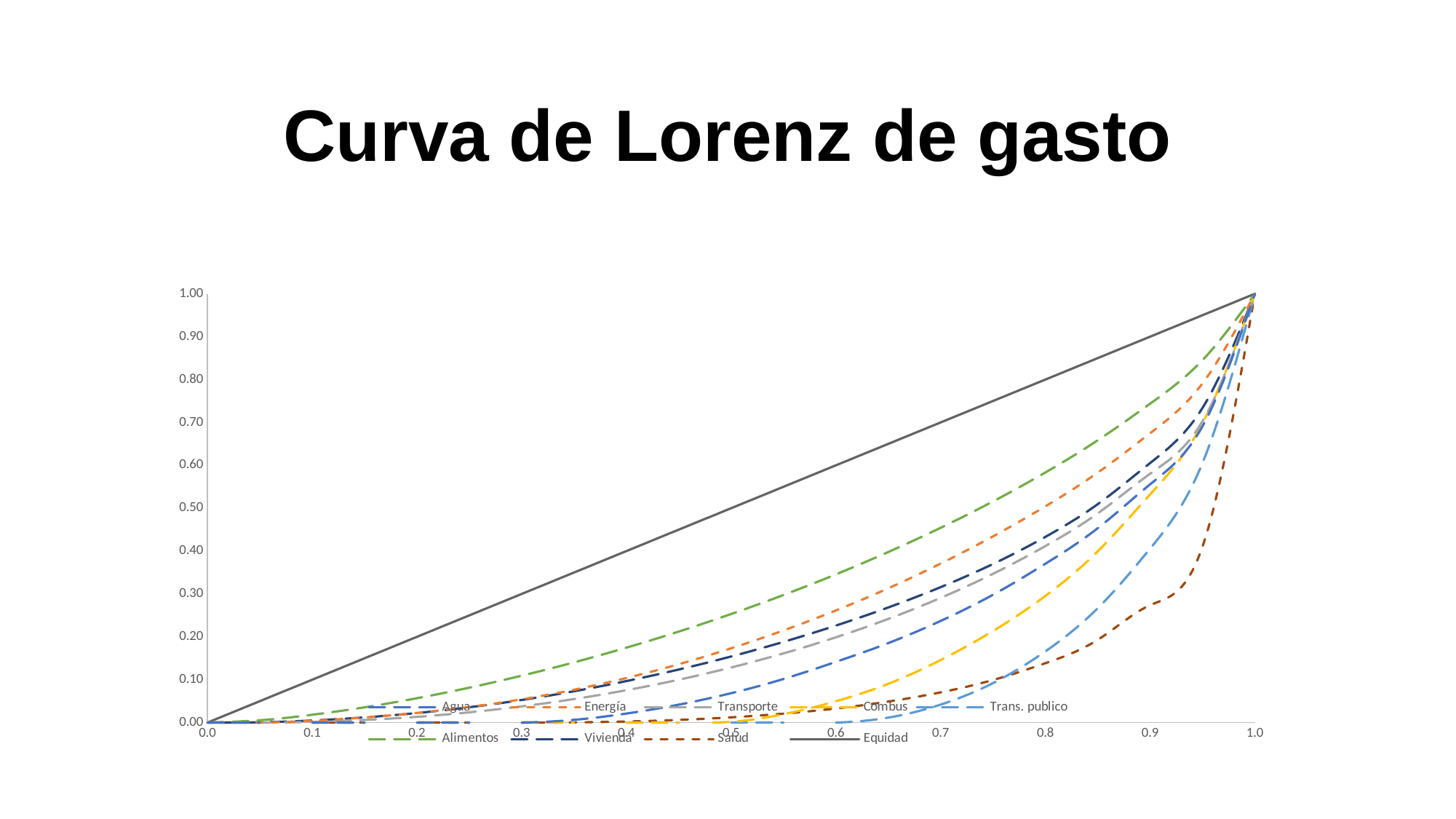
At x = 0.8, which is larger, the value for Alimentos or the value for Salud? Alimentos How many series does the legend list? 9 What kind of chart is shown on the slide? line chart Among the dashed curves, which series has the highest value at x = 0.5? Alimentos Is the value for Alimentos at x = 0.5 greater or less than 0.10? greater Is the value for Salud at x = 0.8 greater or less than 0.20? less What is the title of the chart? Curva de Lorenz de gasto What value do all the curves reach at x = 1.0? 1.00 Do the curves rise or fall as the x axis goes from 0.0 to 1.0? rise What is the value of the Equidad line at x = 0.5? 0.50 Which series has the highest value at x = 0.5? Equidad Which series is drawn as a solid straight diagonal line? Equidad